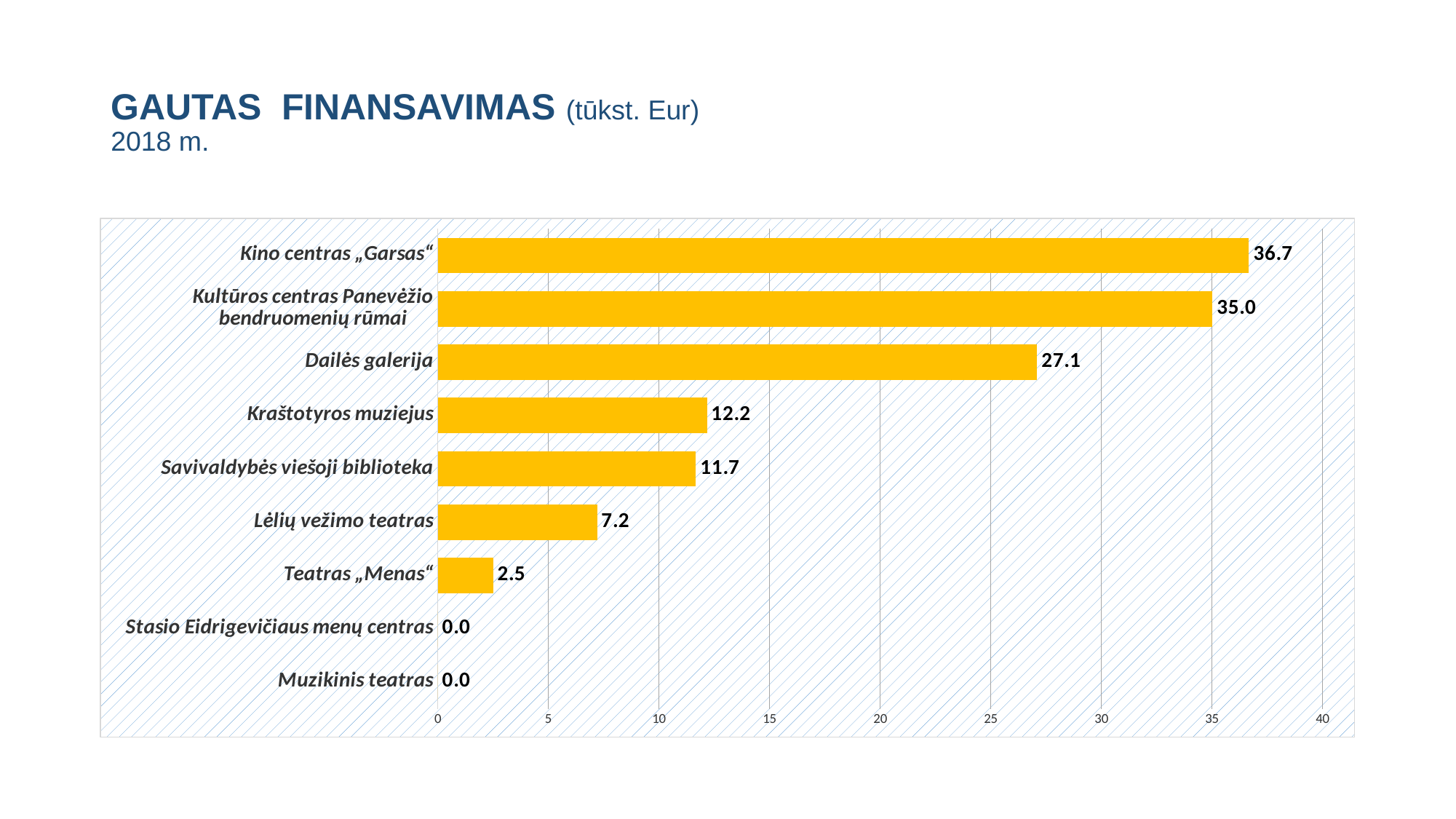
What is the value for Savivaldybės viešoji biblioteka? 11.7 Which is larger, Kraštotyros muziejus or Lėlių vežimo teatras? Kraštotyros muziejus What is the value for Kino centras „Garsas“? 36.7 Is the value for Dailės galerija greater or less than 25? greater Which category has the highest value? Kino centras „Garsas“ What kind of chart is shown on the slide? bar chart What is the difference between Kino centras „Garsas“ and Kultūros centras Panevėžio bendruomenių rūmai? 1.7 What is the value for Dailės galerija? 27.1 What is the difference between Dailės galerija and Kraštotyros muziejus? 14.9 What is the value for Teatras „Menas“? 2.5 How many categories are shown in the chart? 9 How many categories have a value of 0.0? 2